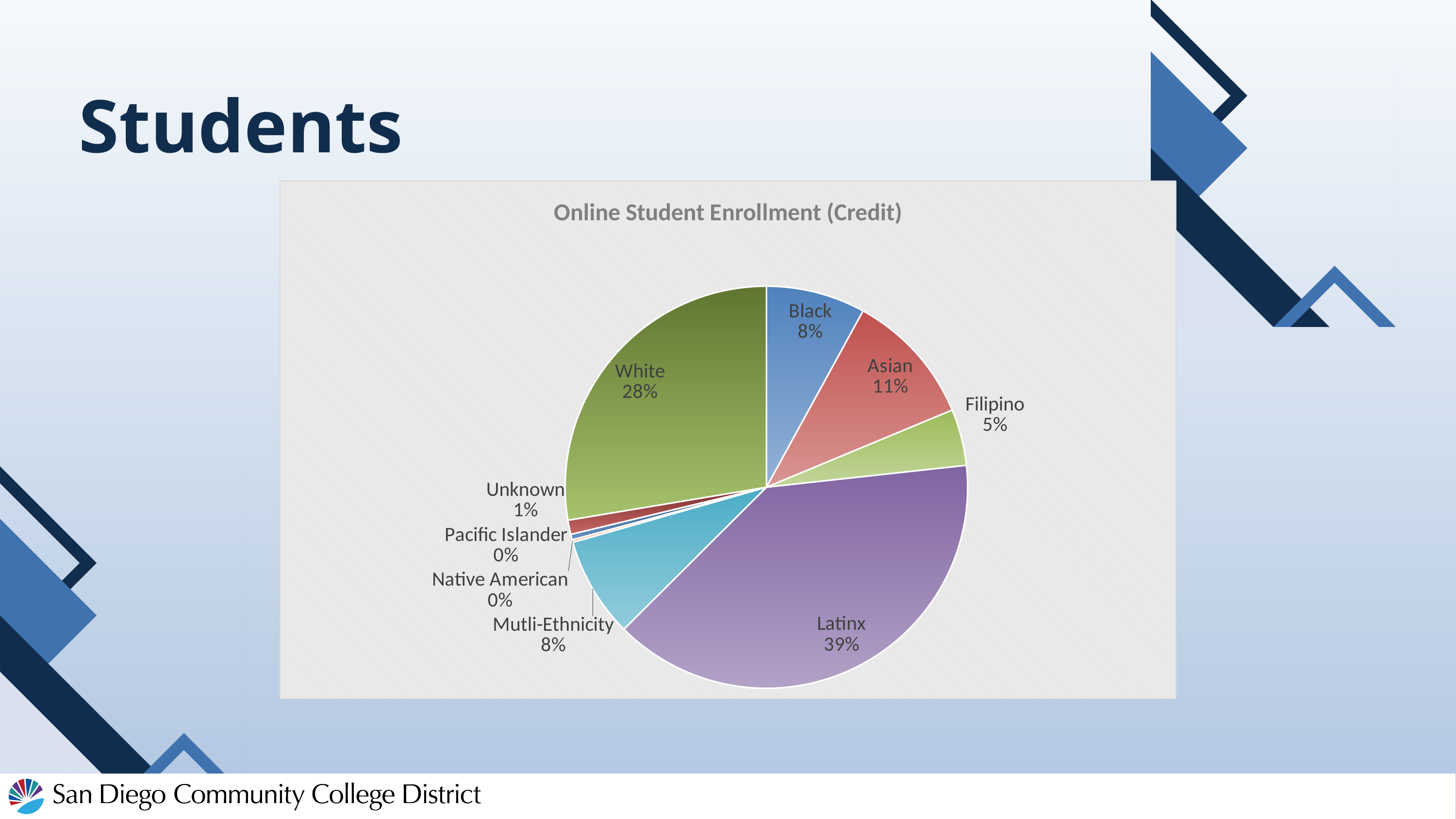
What percentage of online student enrollment is White? 28% What percentage of online student enrollment is Asian? 11% Which group has the largest share of online student enrollment? Latinx What percentage of online student enrollment is Latinx? 39% What is the title of the chart? Online Student Enrollment (Credit) What percentage of online student enrollment is Filipino? 5% What type of chart is shown on the slide? Pie chart How many groups are shown in the pie chart? 9 What is the combined share of the Black and Mutli-Ethnicity slices? 16% What percentage of online student enrollment is Unknown? 1% Which share is larger, Asian or Filipino? Asian How many percentage points larger is the Latinx share than the White share? 11